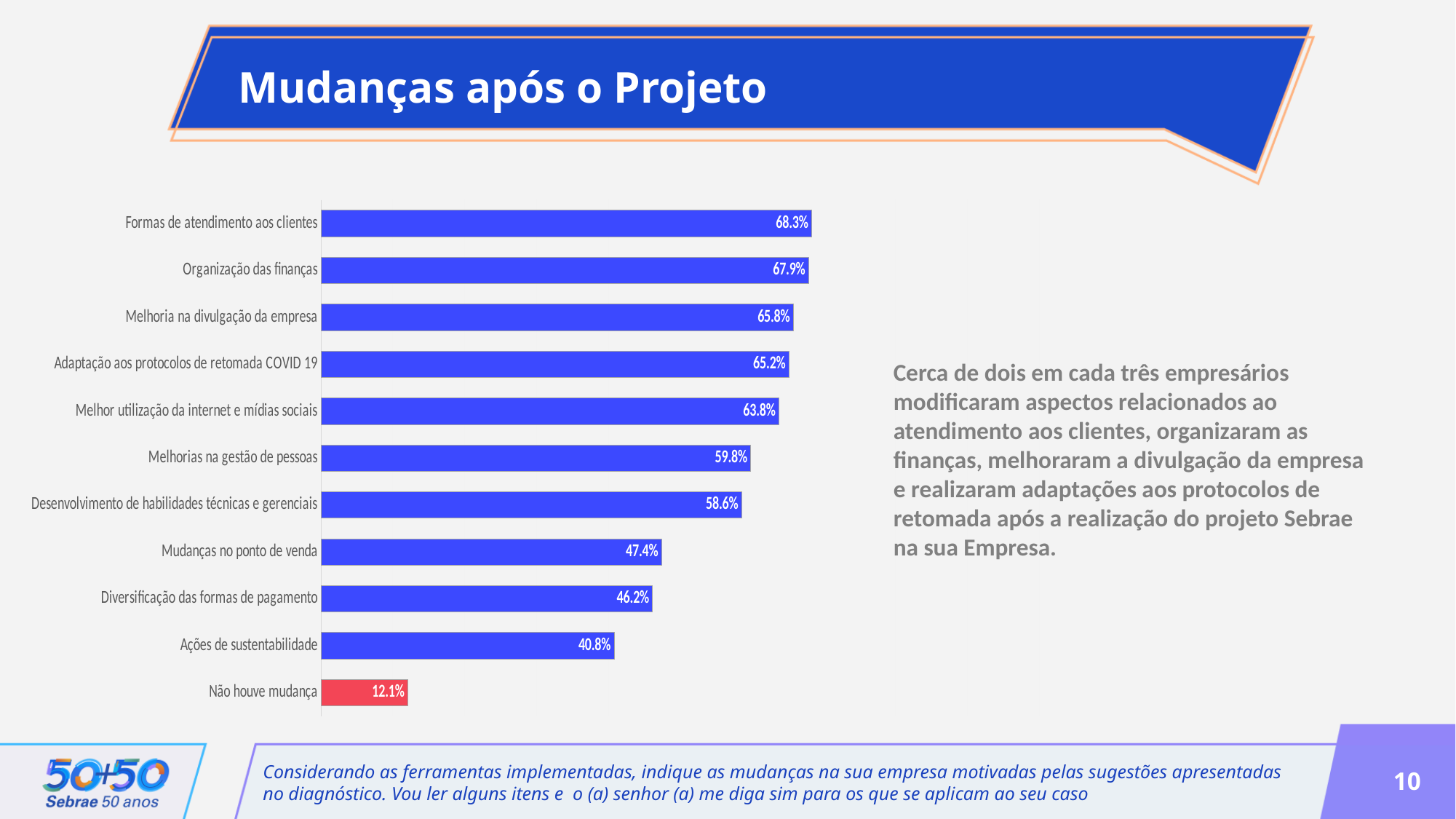
Which is larger: "Mudanças no ponto de venda" or "Desenvolvimento de habilidades técnicas e gerenciais"? Desenvolvimento de habilidades técnicas e gerenciais What is the difference between "Melhor utilização da internet e mídias sociais" and "Adaptação aos protocolos de retomada COVID 19"? 1.4% What is the difference between "Organização das finanças" and "Diversificação das formas de pagamento"? 21.7% What is the value for "Não houve mudança"? 12.1% What is the value for "Ações de sustentabilidade"? 40.8% What kind of chart is shown on the slide? Bar chart How many categories are shown in the chart? 11 What is the value for "Melhorias na gestão de pessoas"? 59.8% Which bar is shown in a different colour (red) from the others? Não houve mudança Which category has the highest value? Formas de atendimento aos clientes What is the value for "Formas de atendimento aos clientes"? 68.3% Which category has the lowest value? Não houve mudança